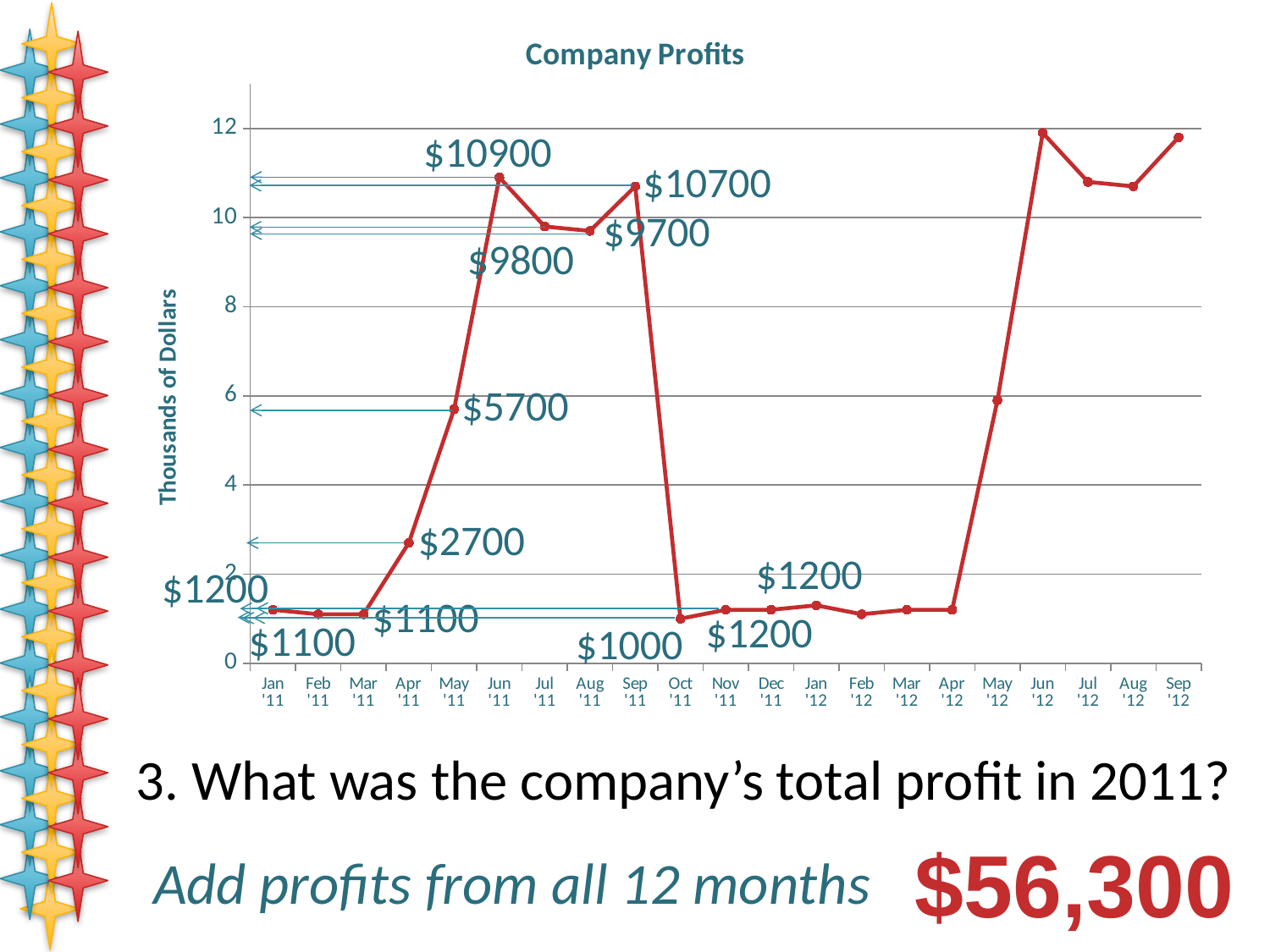
What kind of chart is shown on the slide? Line chart What was the company's total profit in 2011? $56,300 Which month in 2011 had the highest profit? Jun '11 Is the value for Jun '12 greater or less than 10 thousand dollars? greater Which month in 2011 had the lowest profit? Oct '11 Which month had the larger profit, Jul '11 or Aug '11? Jul '11 What is the difference between the profit in Jun '11 and the profit in Sep '11? $200 Is the value for May '12 greater or less than 8 thousand dollars? less What was the company's profit in Jun '11? $10900 How many months are plotted on the x axis of the chart? 21 What was the company's profit in Oct '11? $1000 What was the company's profit in May '11? $5700